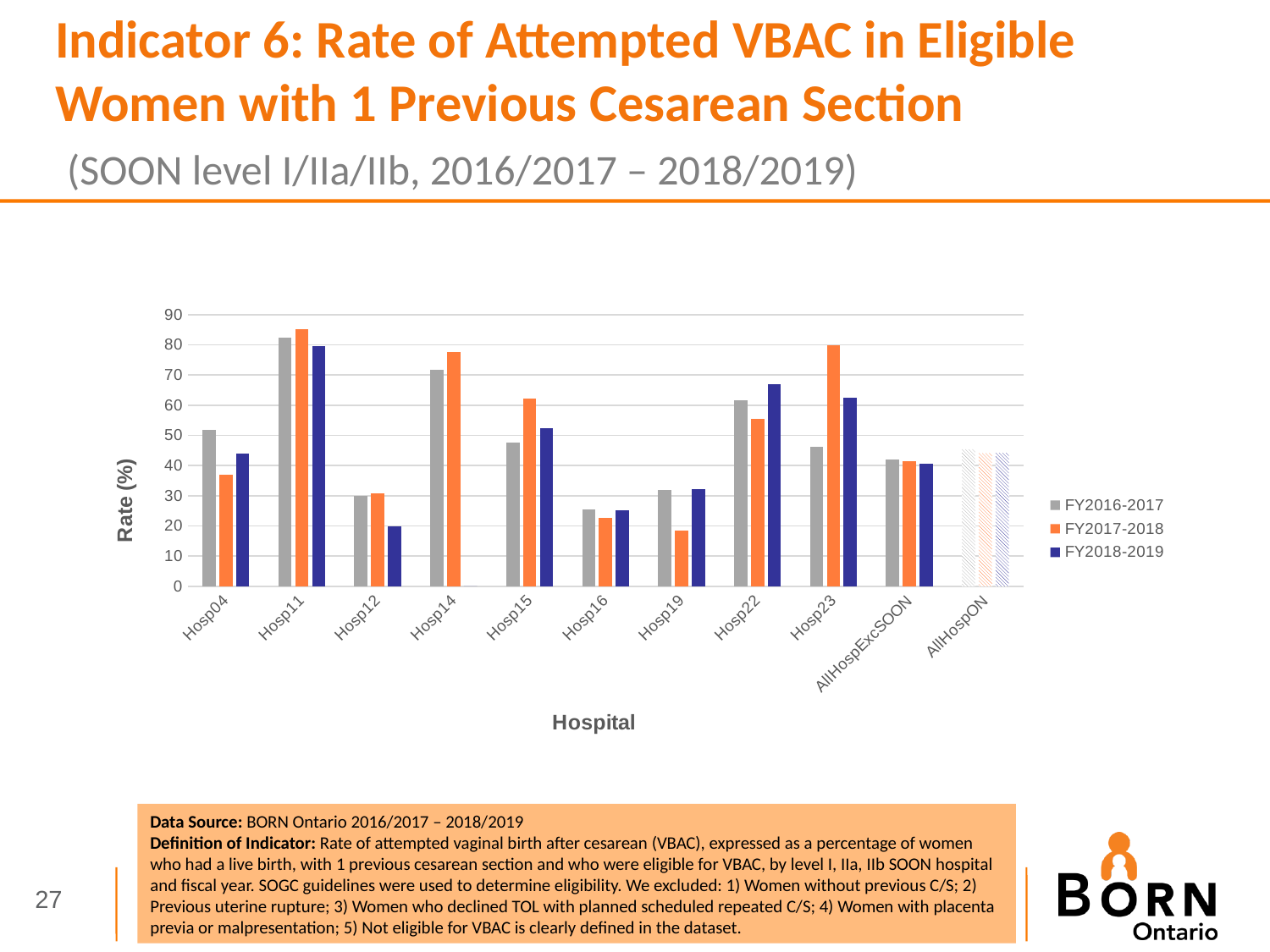
Is the FY2018-2019 value for Hosp12 greater or less than 30? less How many hospital categories are shown on the x axis? 11 Is the FY2017-2018 value for Hosp23 greater or less than 70? greater What is the title of the y axis? Rate (%) Which hospital has the highest FY2016-2017 rate? Hosp11 Which hospital has the highest FY2017-2018 rate? Hosp11 What kind of chart is shown on the slide? Bar chart Which hospital has the lowest FY2017-2018 rate? Hosp19 Is the FY2017-2018 value for Hosp11 greater or less than 80? greater How many series does the legend list? 3 For Hosp22, which is larger: the FY2017-2018 value or the FY2018-2019 value? FY2018-2019